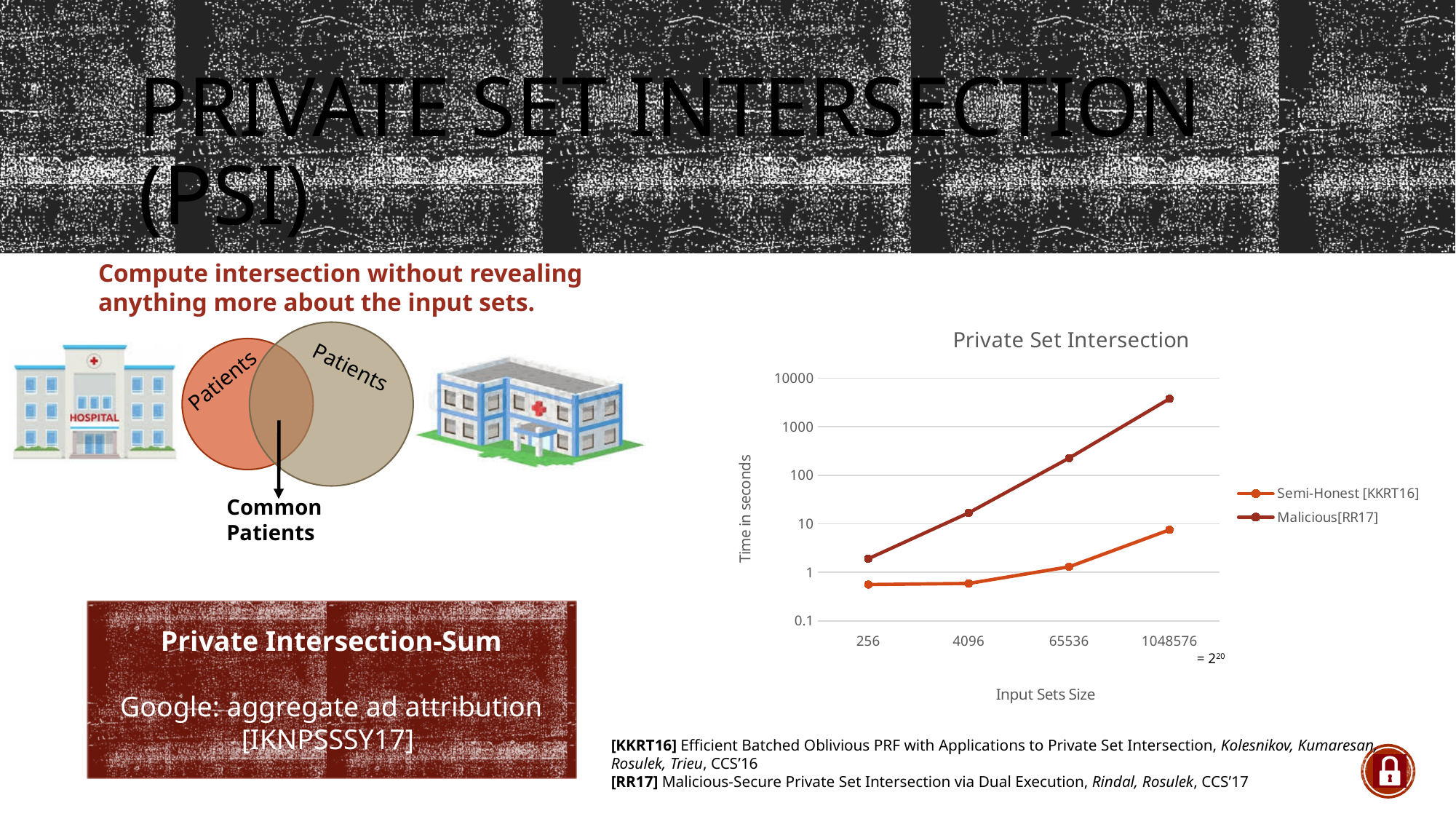
What kind of chart is shown on the slide? line chart At input set size 65536, which series has the larger value, Semi-Honest [KKRT16] or Malicious[RR17]? Malicious[RR17] What is the label of the y axis of the chart? Time in seconds How many series does the chart legend list? 2 Is the value for Malicious[RR17] at input set size 4096 greater or less than 10? greater Is the value for Malicious[RR17] at input set size 1048576 greater or less than 1000? greater Is the value for Semi-Honest [KKRT16] at input set size 256 greater or less than 1? less What is the title of the chart? Private Set Intersection Does the Semi-Honest [KKRT16] series rise or fall as the input set size increases? rise How many input set sizes are plotted along the x axis of the chart? 4